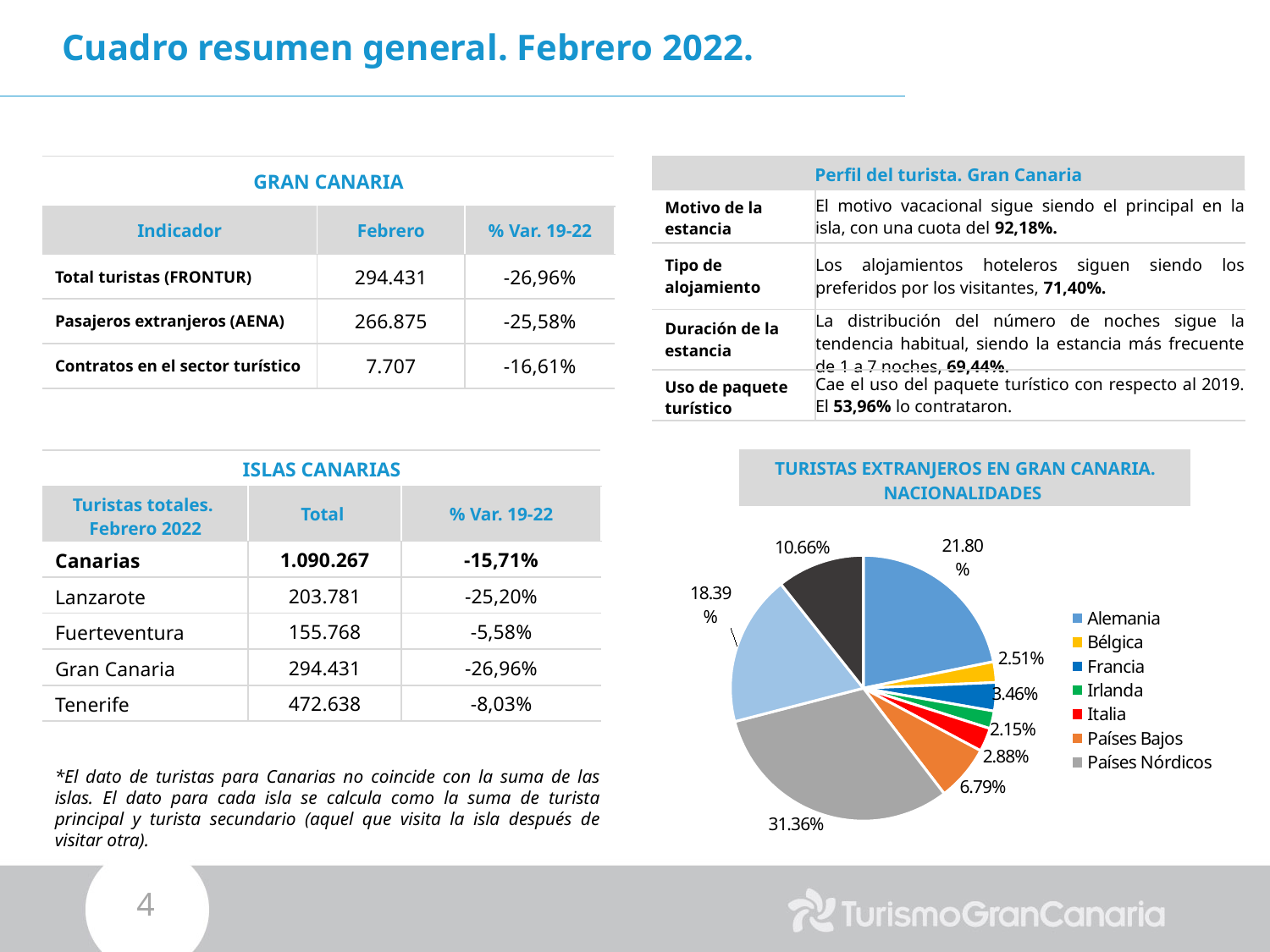
In the pie chart, which slice is larger, Francia or Bélgica? Francia In the pie chart, what share is labelled for Bélgica? 2.51% Which nationality in the legend has the smallest slice of the pie chart? Irlanda In the pie chart, what share is labelled for Países Nórdicos? 31.36% What type of chart is shown under the title 'TURISTAS EXTRANJEROS EN GRAN CANARIA. NACIONALIDADES'? Pie chart How many nationalities are listed in the legend of the pie chart? 7 Which nationality in the legend has the largest slice of the pie chart? Países Nórdicos In the pie chart, what is the difference in percentage points between the Alemania slice and the Países Bajos slice? 15.01 In the pie chart, what share is labelled for Países Bajos? 6.79% In the pie chart, what share is labelled for Francia? 3.46% In the pie chart, what share is labelled for Alemania? 21.80% In the pie chart, what share is labelled for Italia? 2.88%